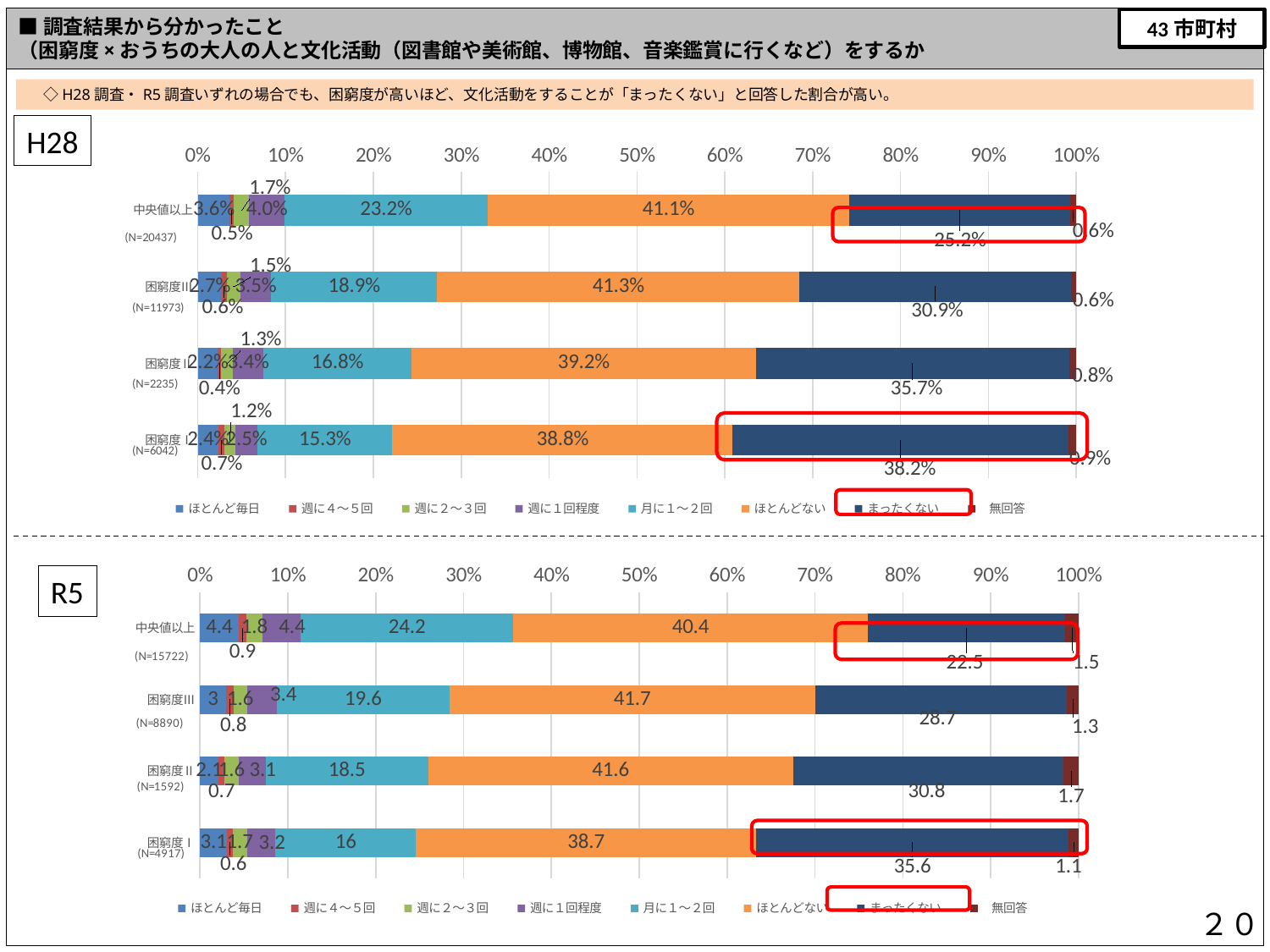
In the H28 chart, what is the value of ほとんどない for 困窮度I? 38.8% How many series does the legend of the H28 chart list? 8 In the H28 chart, which category has the highest value for まったくない? 困窮度I In the R5 chart, does the まったくない value rise or fall going from 中央値以上 down to 困窮度I? Rises In the R5 chart, what is the value of まったくない for 困窮度I? 35.6 In the R5 chart, which category has the lowest value for まったくない? 中央値以上 What kind of chart is the H28 chart? Stacked horizontal bar chart In the R5 chart, which is larger: the 月に1〜2回 value for 困窮度III or for 困窮度I? 困窮度III In the H28 chart, what percentage of 中央値以上 answered まったくない? 25.2% How many categories (bars) does the R5 chart show? 4 In the H28 chart, what is the difference between the まったくない values for 困窮度I and 中央値以上? 13.0% In the R5 chart, what is the value of 月に1〜2回 for 中央値以上? 24.2